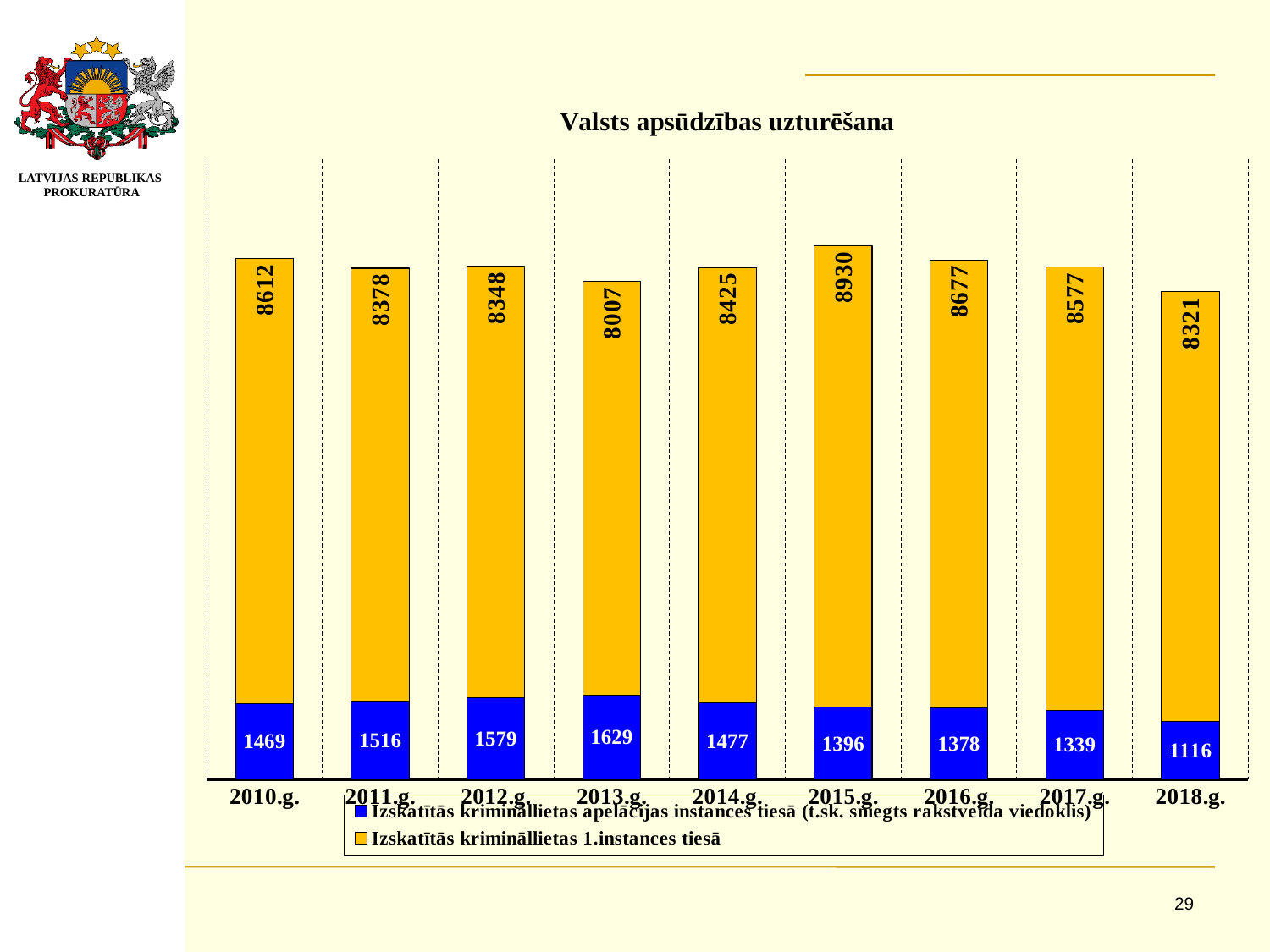
In which year is the value for 'Izskatītās krimināllietas apelācijas instances tiesā' the lowest? 2018.g. What type of chart is shown on the slide? Stacked bar chart What is the title of the chart? Valsts apsūdzības uzturēšana What is the difference between the 'Izskatītās krimināllietas 1.instances tiesā' values for 2015.g. and 2018.g.? 609 In which year is the value for 'Izskatītās krimināllietas apelācijas instances tiesā' the highest? 2013.g. What is the total of the stacked bar for 2018.g.? 9437 How many years are shown on the x axis? 9 What is the value for 'Izskatītās krimināllietas apelācijas instances tiesā' in 2013.g.? 1629 What is the value for 'Izskatītās krimināllietas 1.instances tiesā' in 2015.g.? 8930 How many series does the legend list? 2 Which is larger: the 'Izskatītās krimināllietas 1.instances tiesā' value for 2010.g. or for 2016.g.? 2016.g. In which year is the value for 'Izskatītās krimināllietas 1.instances tiesā' the lowest? 2013.g.